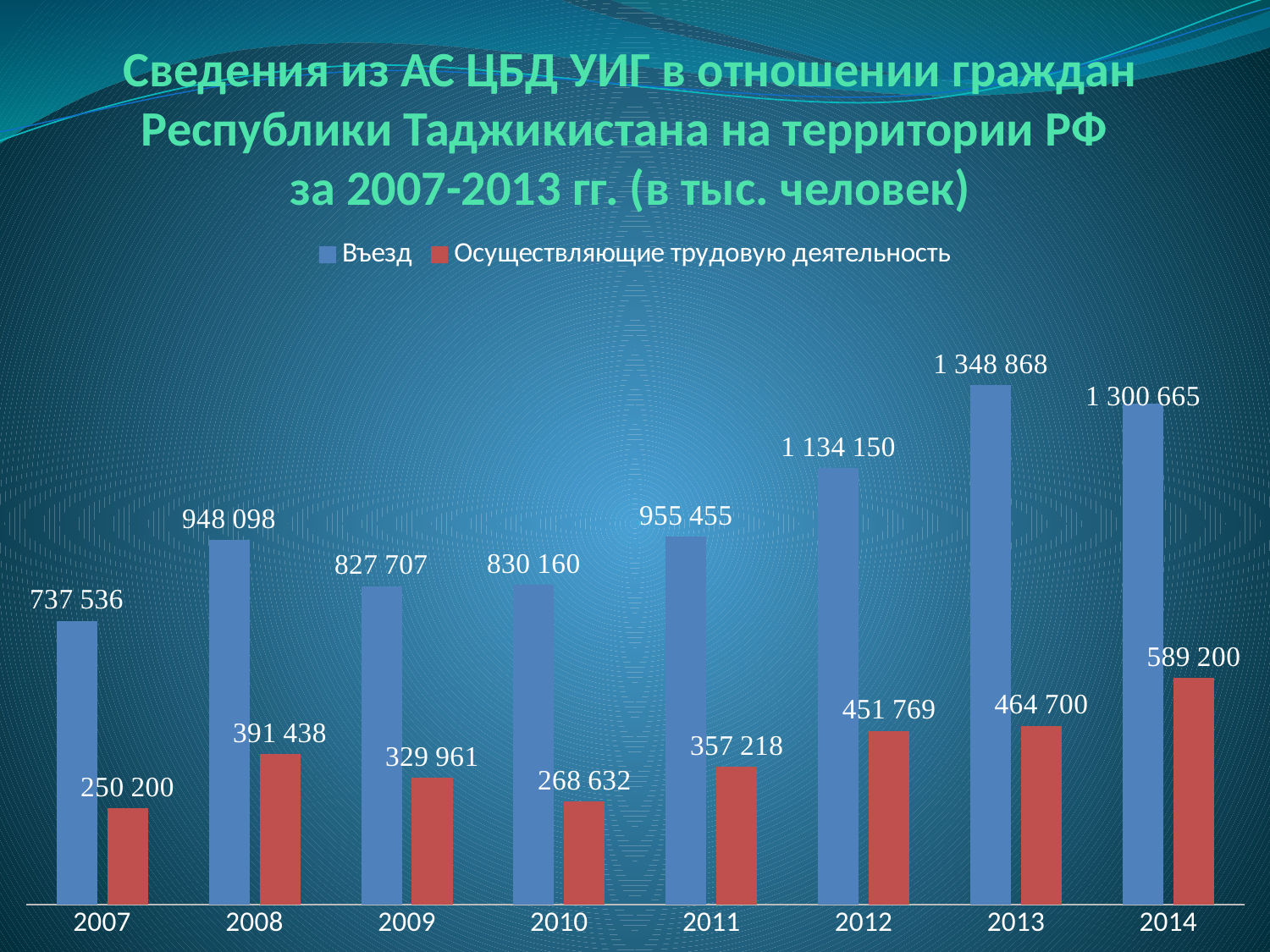
In which year is the Въезд value highest? 2013 What is the difference between Въезд and Осуществляющие трудовую деятельность in 2014? 711 465 What is the value of Въезд for 2013? 1 348 868 How many series does the legend list? 2 What is the value of Осуществляющие трудовую деятельность for 2007? 250 200 In which year is the Осуществляющие трудовую деятельность value lowest? 2007 By how much did Въезд increase from 2012 to 2013? 214 718 What is the value of Въезд for 2010? 830 160 How many years are shown on the x axis? 8 Which year has the larger Въезд value, 2008 or 2011? 2011 What kind of chart is shown on the slide? Bar chart What is the value of Осуществляющие трудовую деятельность for 2014? 589 200